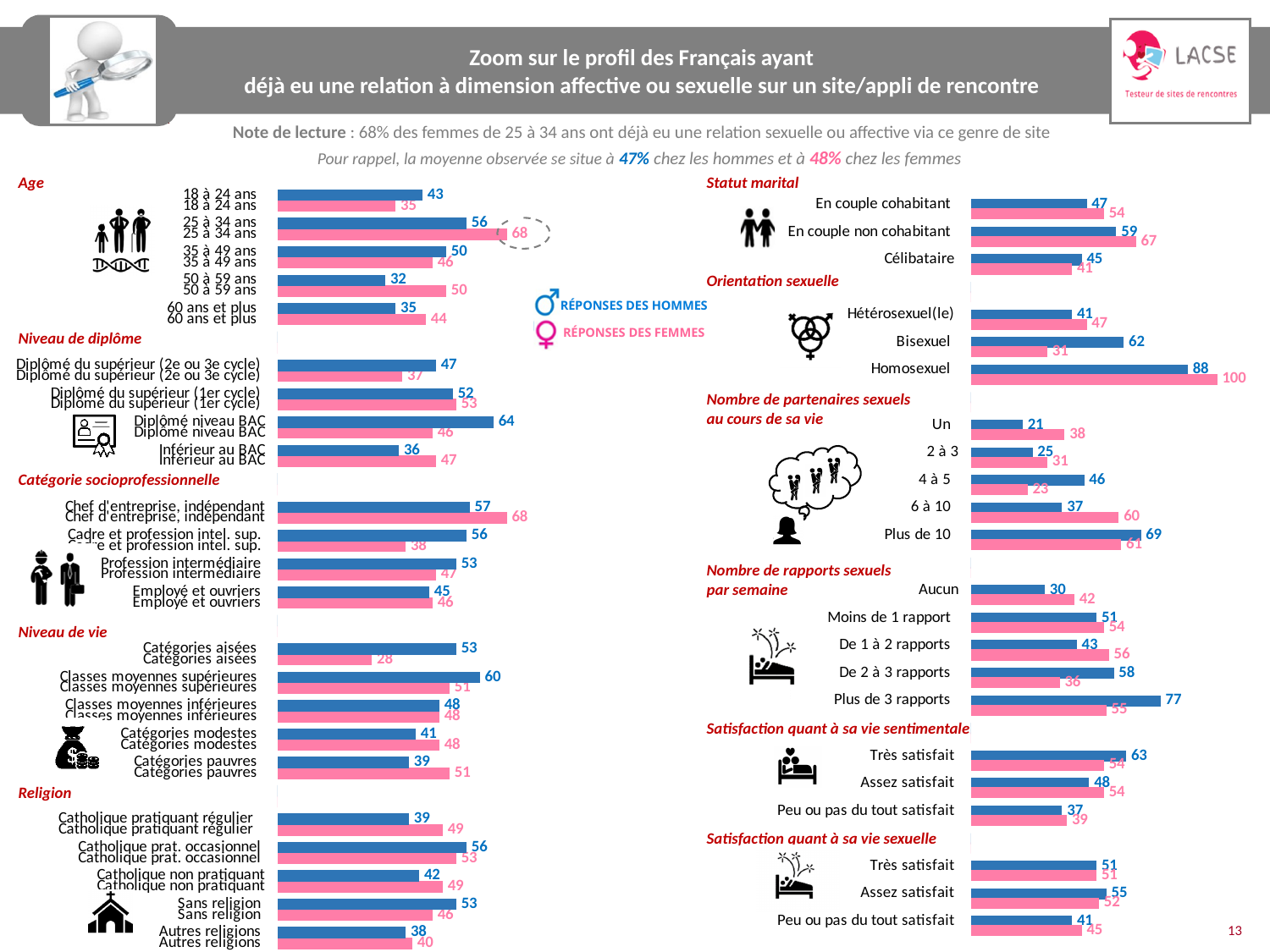
In the 'Catégorie socioprofessionnelle' chart, what is the value for women in 'Chef d'entreprise, indépendant'? 68 What kind of chart is used for the 'Statut marital' data? bar chart In the 'Niveau de diplôme' chart, which category has the highest value for men? Diplômé niveau BAC How many series does the legend list for the charts on this slide? 2 In the 'Nombre de partenaires sexuels au cours de sa vie' chart, which category has the lowest value for men? Un In the 'Niveau de vie' chart, what is the difference between the men's and women's values for Catégories aisées? 25 In the 'Satisfaction quant à sa vie sentimentale' chart, what is the men's value for 'Très satisfait'? 63 How many categories does the 'Religion' chart show? 5 Which colour represents the women's responses (Réponses des femmes) in the charts? pink In the 'Orientation sexuelle' chart, what is the value for women who are Homosexuel? 100 In the 'Age' chart, what is the value for women aged 25 à 34 ans? 68 In the 'Nombre de rapports sexuels par semaine' chart, which is larger for 'Plus de 3 rapports': the men's value or the women's value? the men's value